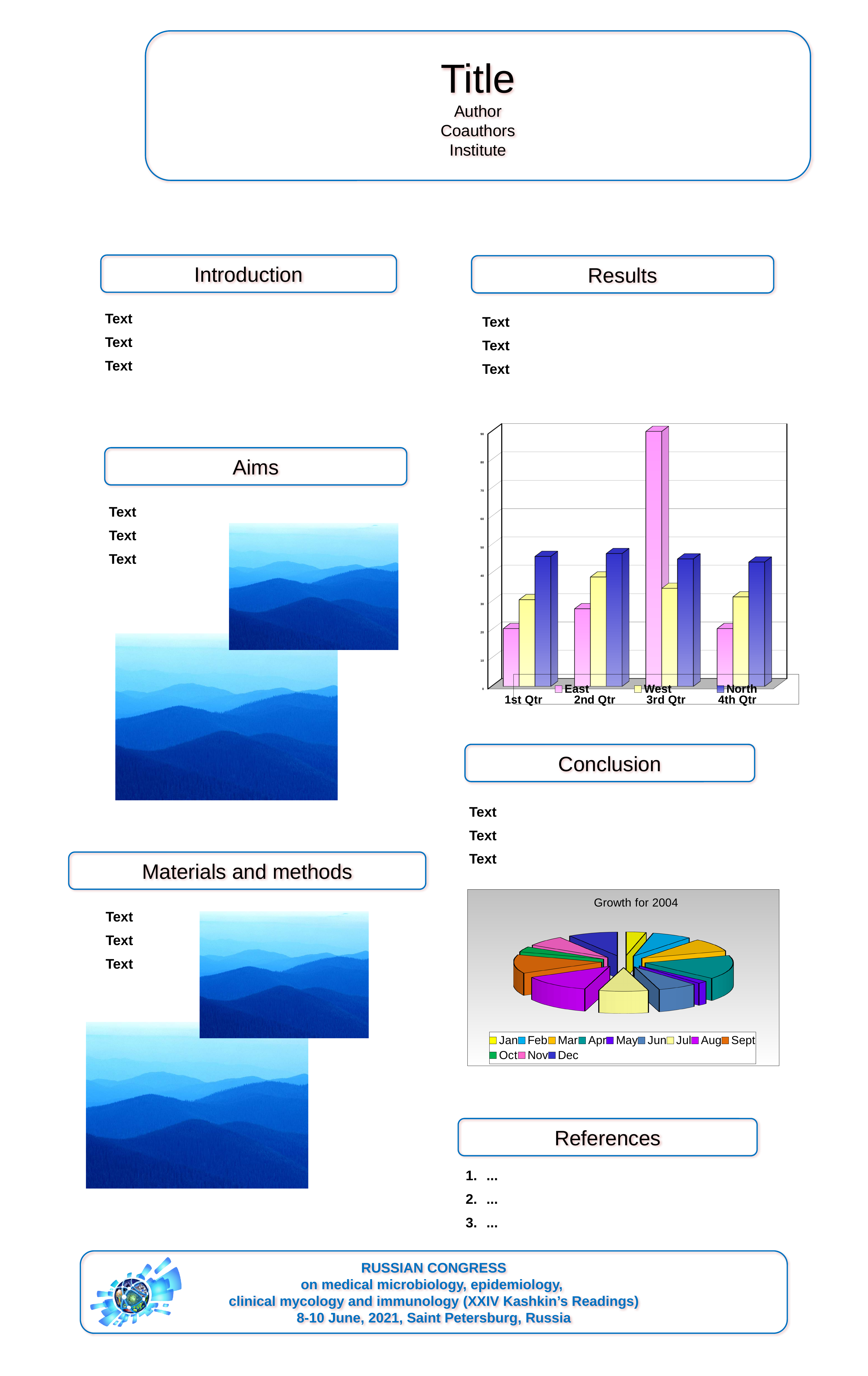
In the bar chart in the Results section, how many quarter categories are shown on the x axis? 4 In the bar chart in the Results section, which is larger for 1st Qtr, West or North? North In the bar chart in the Results section, how many series does the legend list? 3 How many slices does the pie chart titled 'Growth for 2004' have? 12 In the bar chart in the Results section, is the North value for 3rd Qtr greater or less than 40? greater What kind of chart is the upper chart in the Results section? bar chart In the bar chart in the Results section, which is larger for 2nd Qtr, East or West? West In the bar chart in the Results section, is the East value for 3rd Qtr greater or less than 80? greater In the bar chart in the Results section, is the East value for 1st Qtr greater or less than 30? less What kind of chart is the chart titled 'Growth for 2004'? pie chart In the bar chart in the Results section, which series is shown in pink? East In the bar chart in the Results section, which quarter has the highest East value? 3rd Qtr